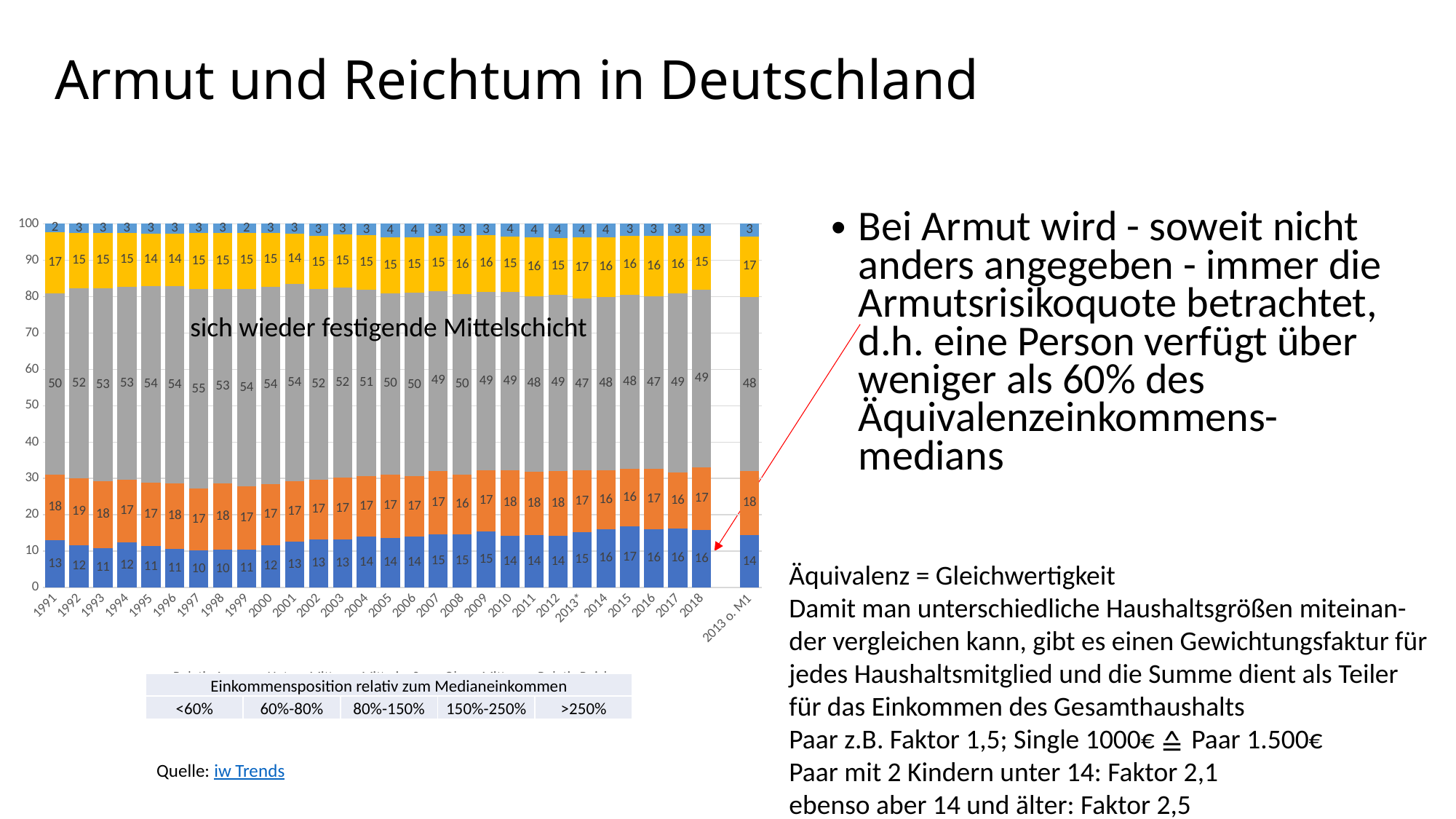
How many bars are shown on the x axis? 29 In which year is the <60% series highest? 2015 Which year has the larger 60%-80% value, 1992 or 2014? 1992 What is the total of the stacked bar for 2018? 100 What is the title shown above the legend entries? Einkommensposition relativ zum Medianeinkommen What is the difference between the <60% value for 2015 and for 1997? 7 How many series does the legend list? 5 What kind of chart is shown on the slide? Stacked bar chart In which year is the 80%-150% series highest? 1997 What is the value of the <60% series for 2018? 16 What is the value of the 80%-150% series for 1991? 50 What is the value of the 150%-250% series for 2013*? 17